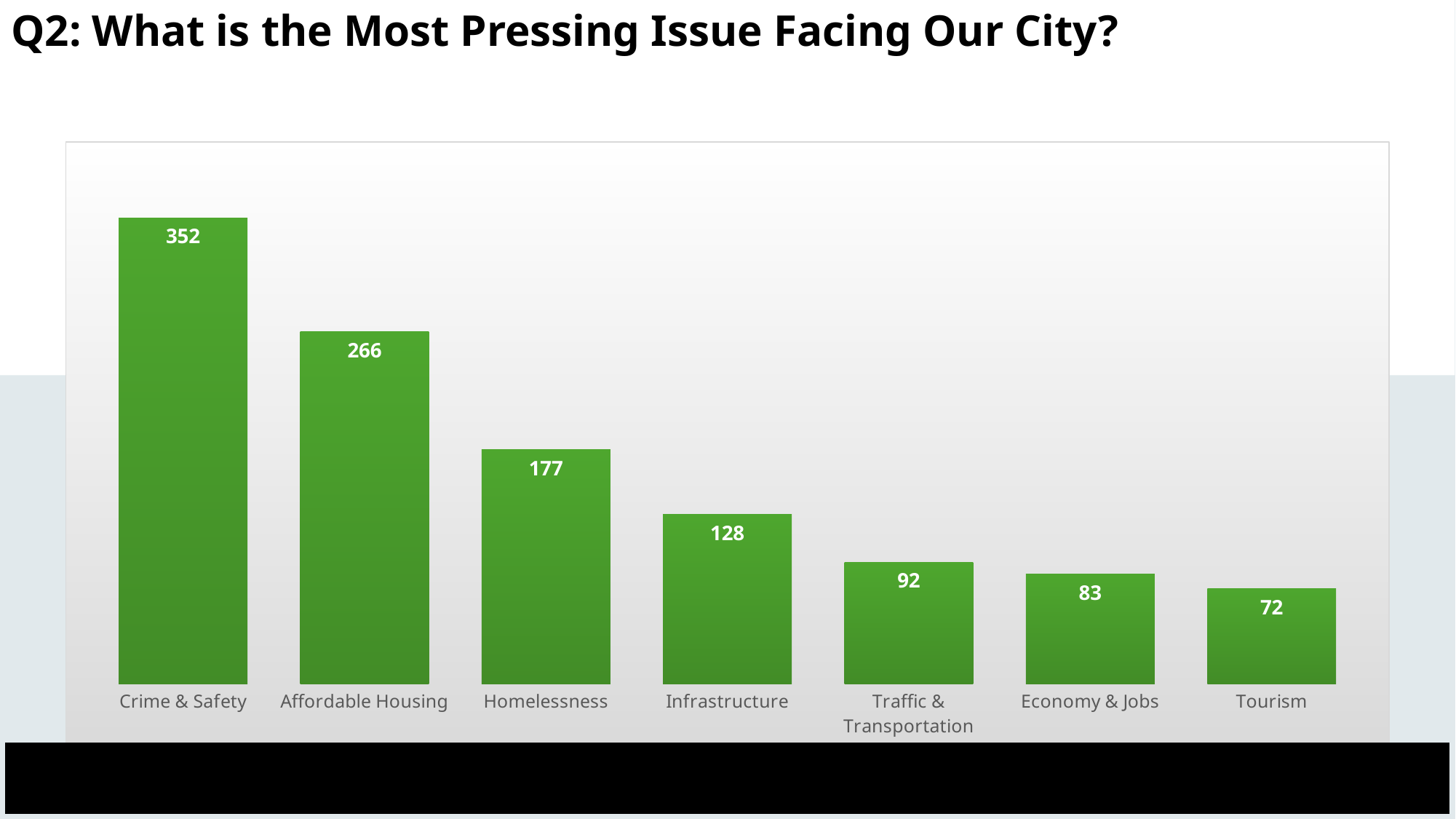
How many categories are shown in the chart? 7 What is the value for Affordable Housing? 266 What is the value for Traffic & Transportation? 92 What kind of chart is shown on the slide? Bar chart Which is larger, the value for Economy & Jobs or the value for Tourism? Economy & Jobs Which category has the lowest value? Tourism What is the value for Crime & Safety? 352 Which category has the highest value? Crime & Safety Do the values rise or fall from left to right along the x axis? Fall What is the difference between the values for Crime & Safety and Affordable Housing? 86 What is the value for Tourism? 72 What is the difference between the values for Homelessness and Infrastructure? 49